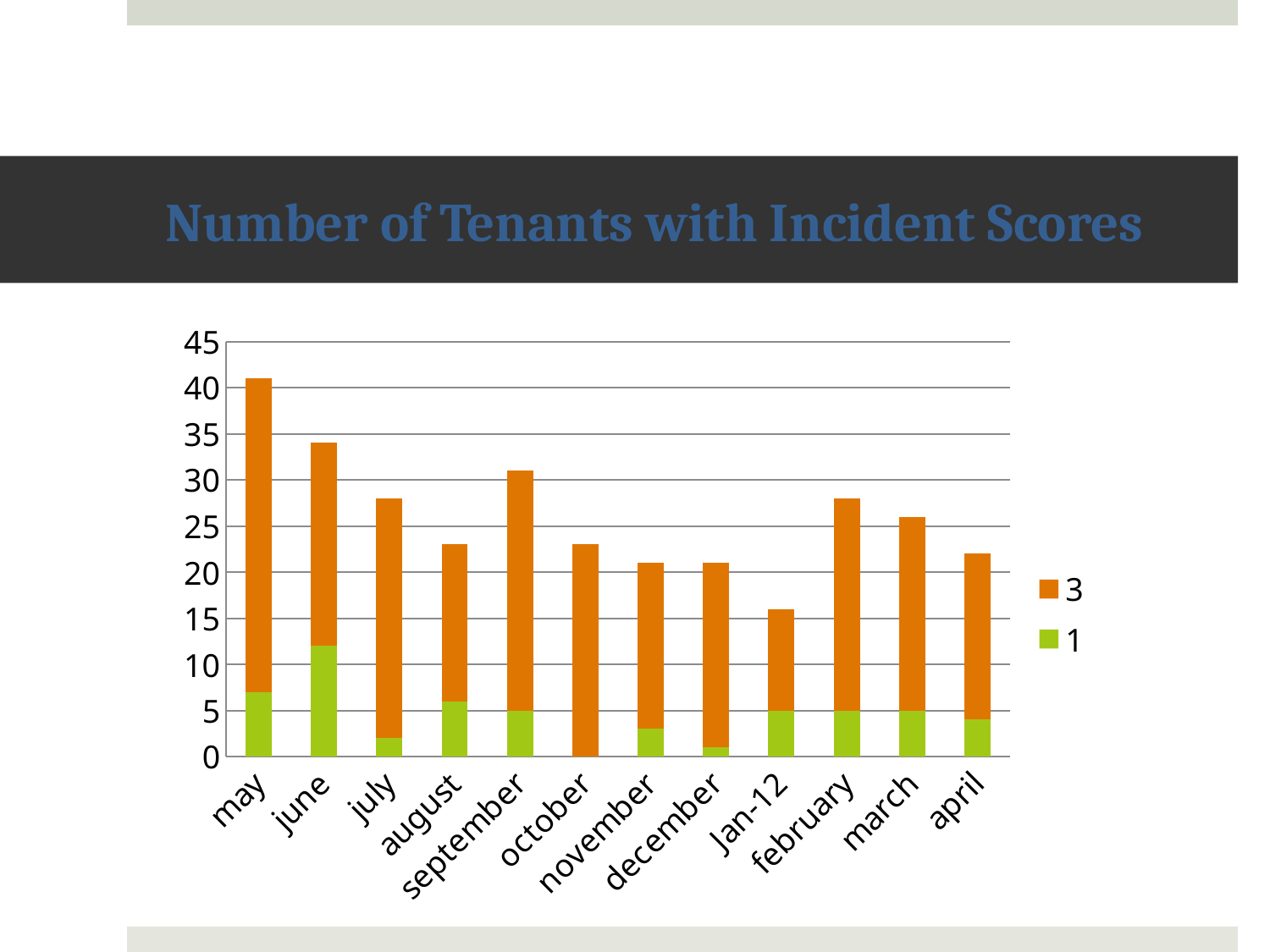
Is the total bar for Jan-12 greater or less than 20? less How many months are shown on the x axis? 12 Which month has the shortest bar? Jan-12 Is the total bar for may greater or less than 40? greater Is the total bar for september greater or less than 30? greater How many series does the legend list? 2 Which bar is taller, june or july? june Which month has the tallest bar? may What is the title of the chart? Number of Tenants with Incident Scores What type of chart is shown on the slide? Stacked bar chart Which colour represents the series labelled 3 in the legend? Orange Do the bar totals generally rise or fall from may to Jan-12? fall